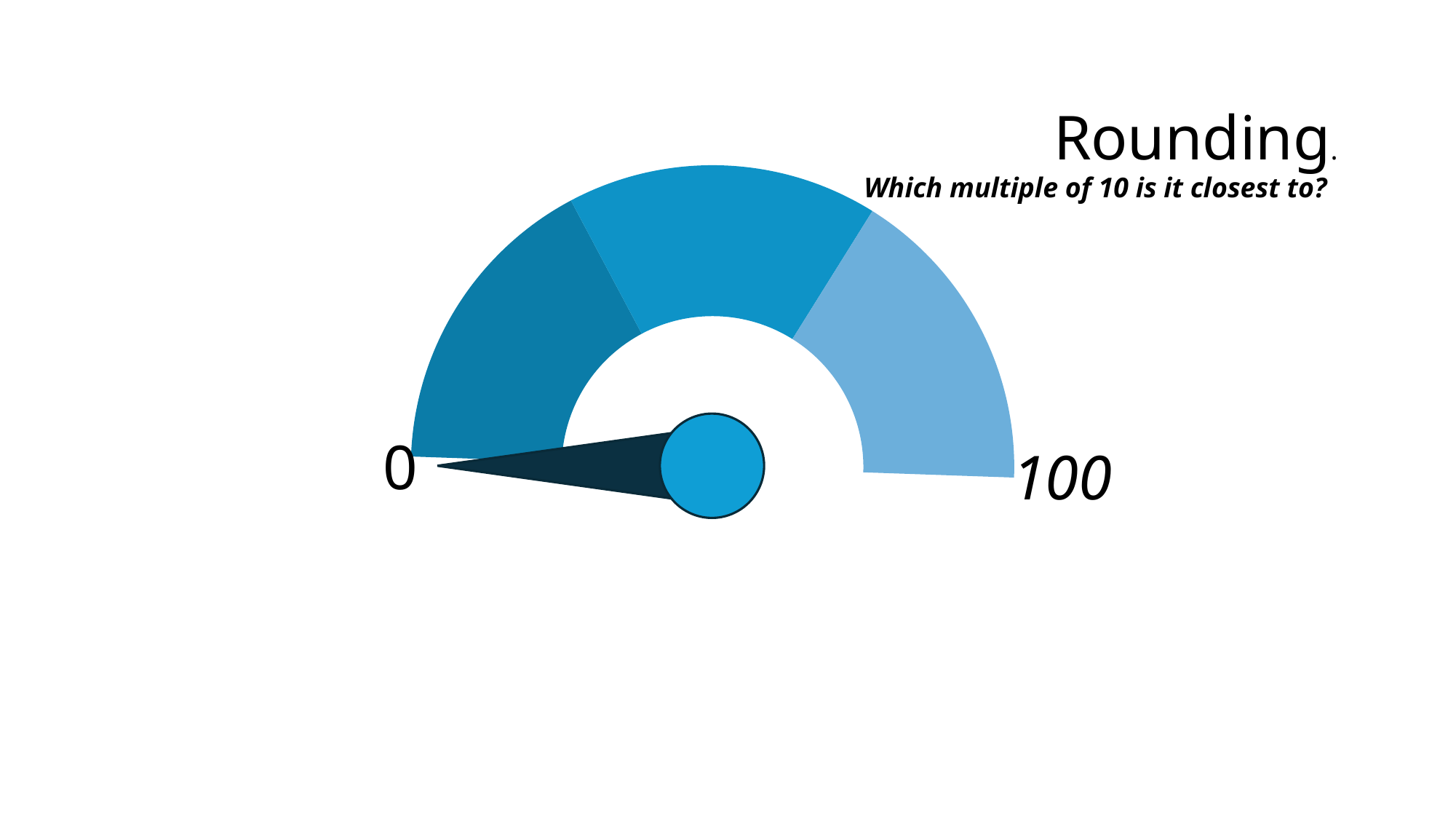
What is the title of the chart? Rounding. What question is written beneath the chart title? Which multiple of 10 is it closest to? How many coloured segments make up the gauge arc? 3 What value does the needle of the gauge point to? 0 What is the lowest value labelled on the gauge scale? 0 What is the highest value labelled on the gauge scale? 100 What kind of chart is shown on the slide? gauge chart Is the value the needle points to greater or less than 50? less